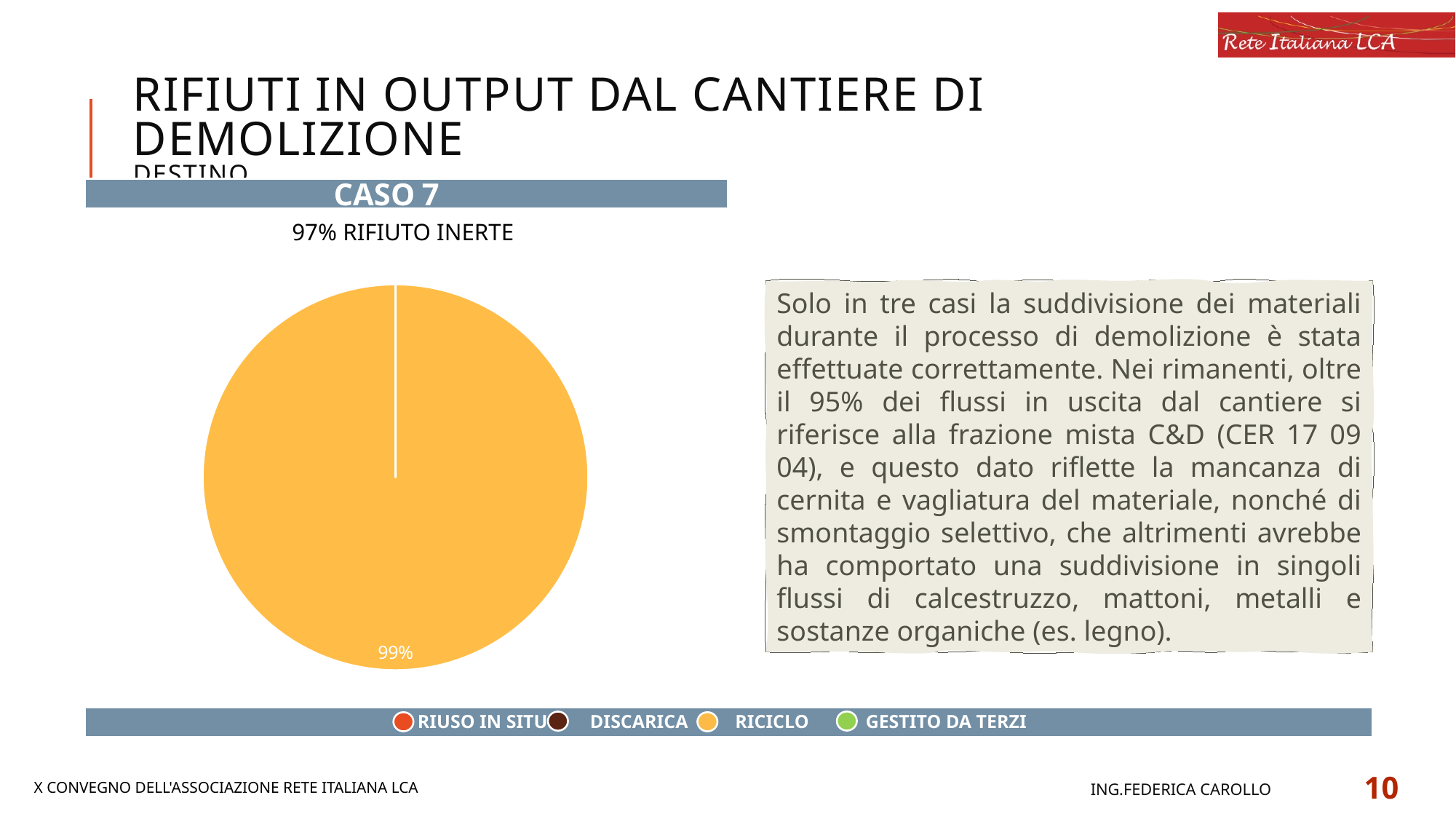
What kind of chart is shown on the slide? pie chart Which category has the largest slice in the pie chart? RICICLO Which case is the pie chart about, according to the heading above it? CASO 7 Which legend category does the large orange slice of the pie chart correspond to? RICICLO What share of the pie does RICICLO account for? 99% Is the share for RICICLO greater or less than 50%? greater How many categories does the legend of the pie chart list? 4 Is the share for RICICLO greater or less than 90%? greater What percentage is printed on the large slice of the pie chart? 99%